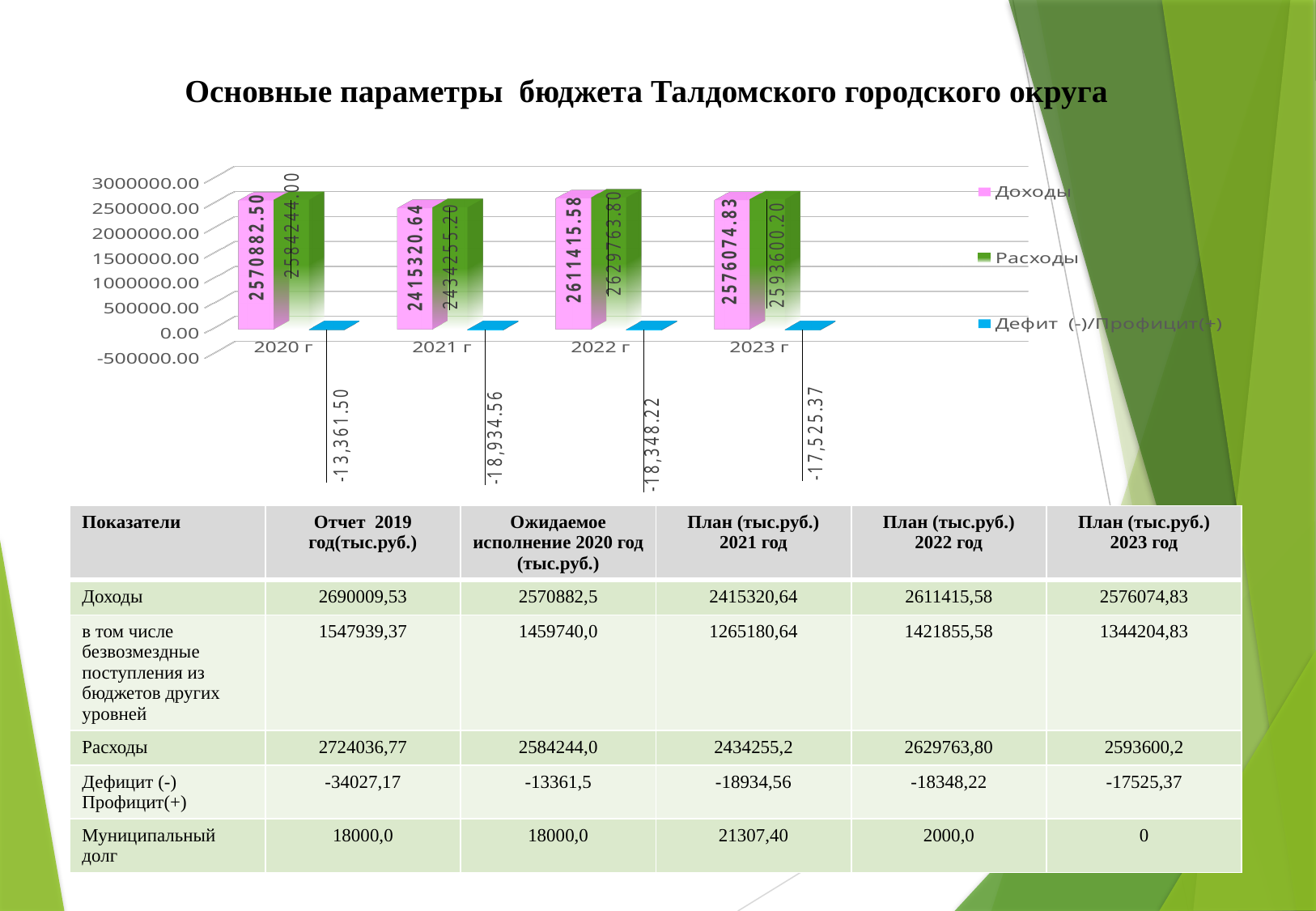
What is the difference between Расходы and Доходы for 2022 г in the chart? 18348.22 Is the value of Доходы for 2021 г greater or less than 2500000.00? less What kind of chart is shown on the slide? bar chart How many series does the chart legend list? 3 What is the value of Расходы for 2023 г in the chart? 2593600.20 In which year is the Дефицит (-)/Профицит(+) value the lowest (most negative) in the chart? 2021 г How many years are shown on the x axis of the chart? 4 What is the value of Доходы for 2021 г in the chart? 2415320.64 In which year is Расходы lowest in the chart? 2021 г In which year is Доходы highest in the chart? 2022 г Which is larger in the chart for 2023 г: Доходы or Расходы? Расходы What is the value of Дефицит (-)/Профицит(+) for 2020 г in the chart? -13,361.50